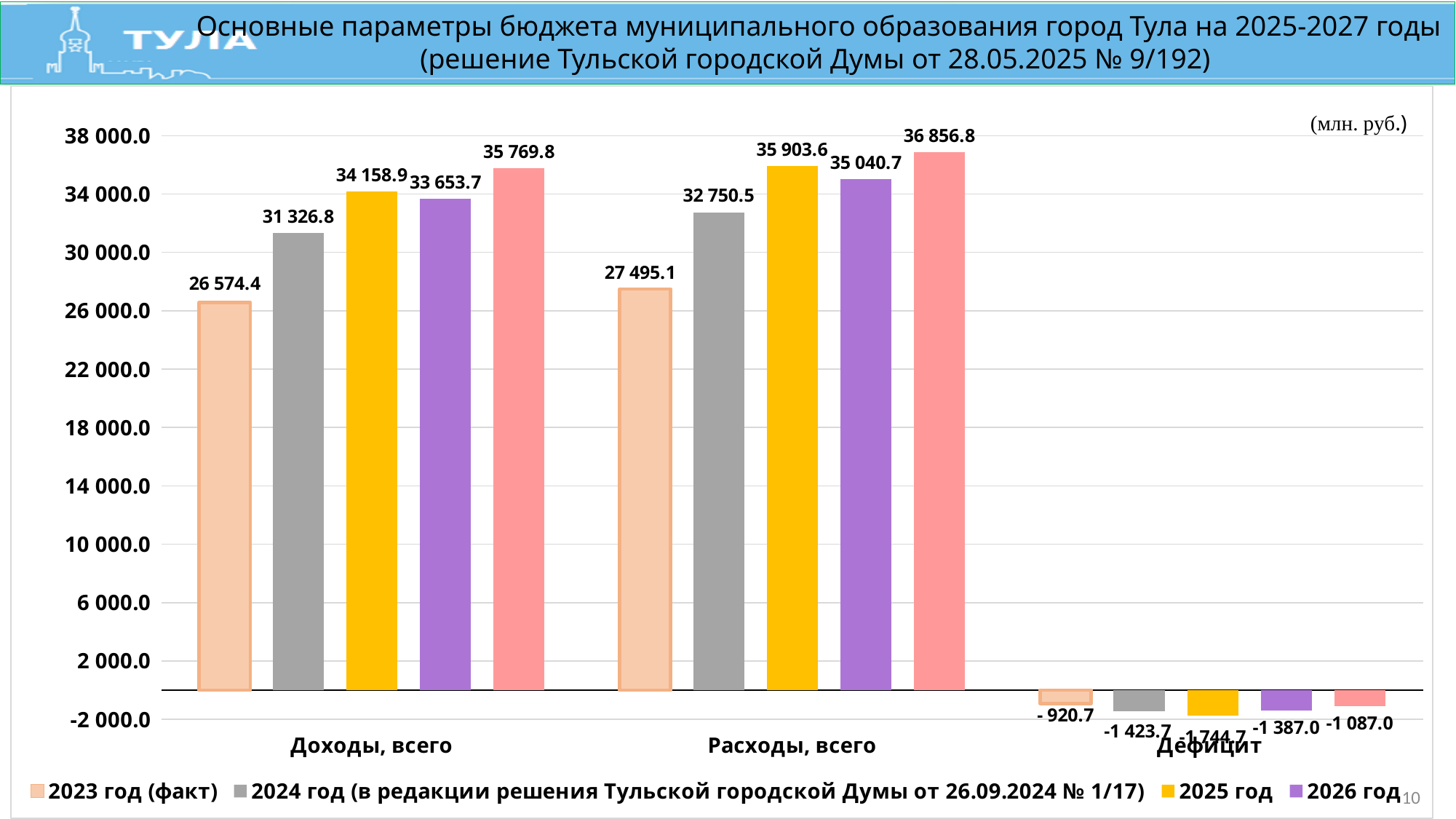
What is the value for 2026 год in the Дефицит category? -1 387.0 What unit of measurement is indicated on the chart? млн. руб. What is the value for 2025 год in the Расходы, всего category? 35 903.6 What is the value for 2023 год (факт) in the Дефицит category? - 920.7 What is the value for 2023 год (факт) in the Доходы, всего category? 26 574.4 How many categories are shown on the x axis? 3 Which category has the highest value for 2025 год? Расходы, всего In the Доходы, всего category, which is larger: the value for 2025 год or for 2026 год? 2025 год Which category has the lowest value for 2024 год? Дефицит By how much does the Доходы, всего value for 2024 год exceed the value for 2023 год (факт)? 4 752.4 What is the difference between the 2025 год values for Расходы, всего and Доходы, всего? 1 744.7 Is the value for 2024 год in the Расходы, всего category greater or less than 30 000.0? greater